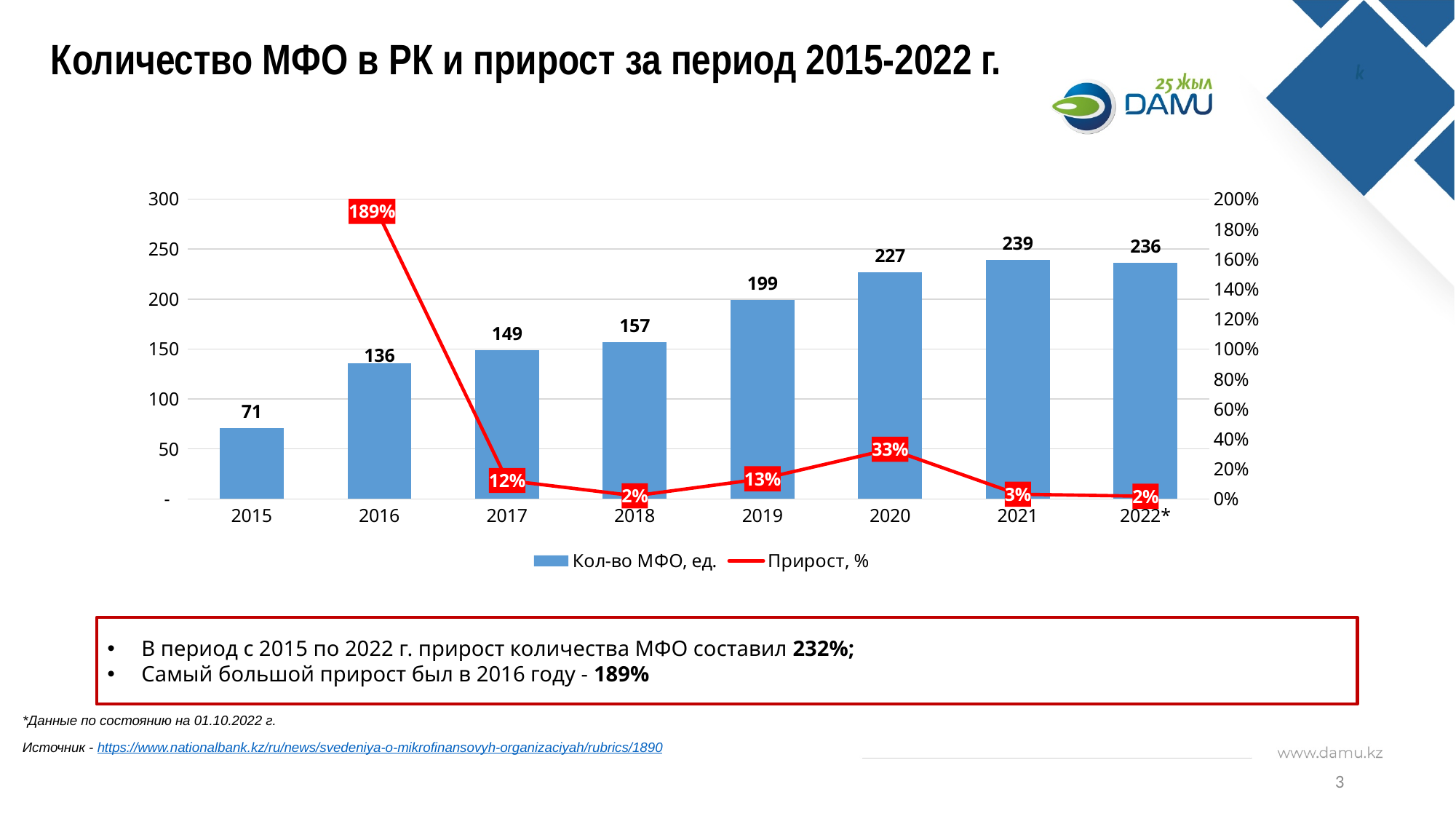
How many series does the legend list? 2 What is the number of MFOs in 2022*? 236 What kind of chart is used for the number of MFOs series? Bar chart Which year has the lowest number of MFOs? 2015 What is the number of MFOs (Кол-во МФО, ед.) in 2019? 199 Which year has the highest number of MFOs? 2021 How many years are shown on the x axis? 8 What is the difference in the number of MFOs between 2021 and 2015? 168 What colour is the line for Прирост, %? Red Does the growth rate (Прирост, %) rise or fall from 2016 to 2017? Fall Which year has a larger number of MFOs, 2017 or 2018? 2018 What is the growth rate (Прирост, %) shown for 2016? 189%